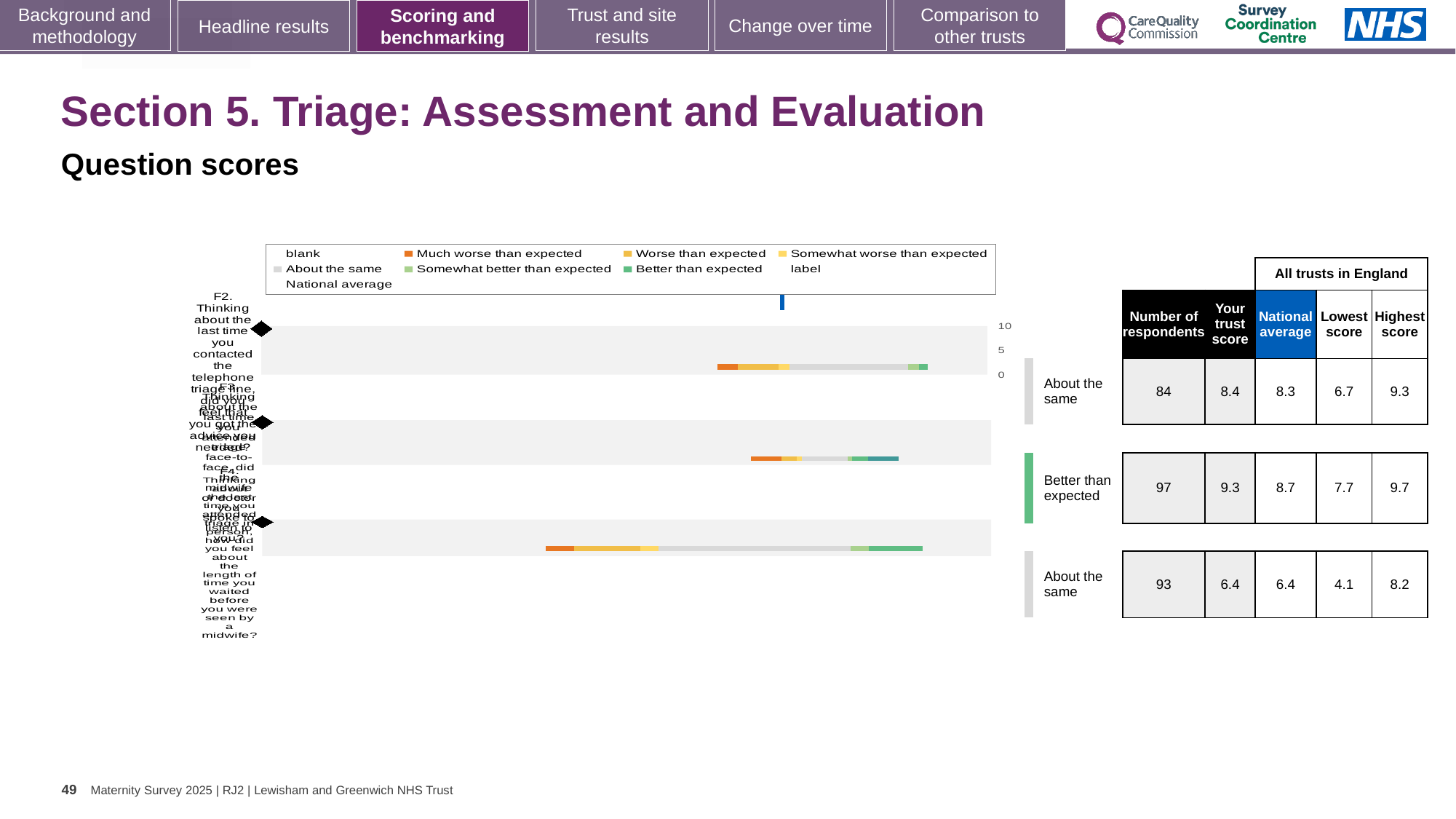
In the table beside the chart, what is the national average for the bottom row (the second "About the same" row)? 6.4 In the table beside the chart, for the "Better than expected" row, which is larger: "Your trust score" or the national average? Your trust score What colour does the legend use for "Much worse than expected"? orange In the table beside the chart, what is "Your trust score" for the row labelled "Better than expected"? 9.3 What kind of chart is shown on the slide? bar chart What colour does the legend use for "Better than expected"? teal green In the table beside the chart, which row has the lowest "Lowest score" value? the bottom "About the same" row (4.1) In the table beside the chart, for the "Better than expected" row, what is the difference between the highest score and the lowest score? 2.0 In the table beside the chart, which row has the highest "Your trust score"? Better than expected How many question bars are plotted in the chart? 3 In the table beside the chart, how many respondents are shown for the row labelled "Better than expected"? 97 How many entries does the chart legend list? 9